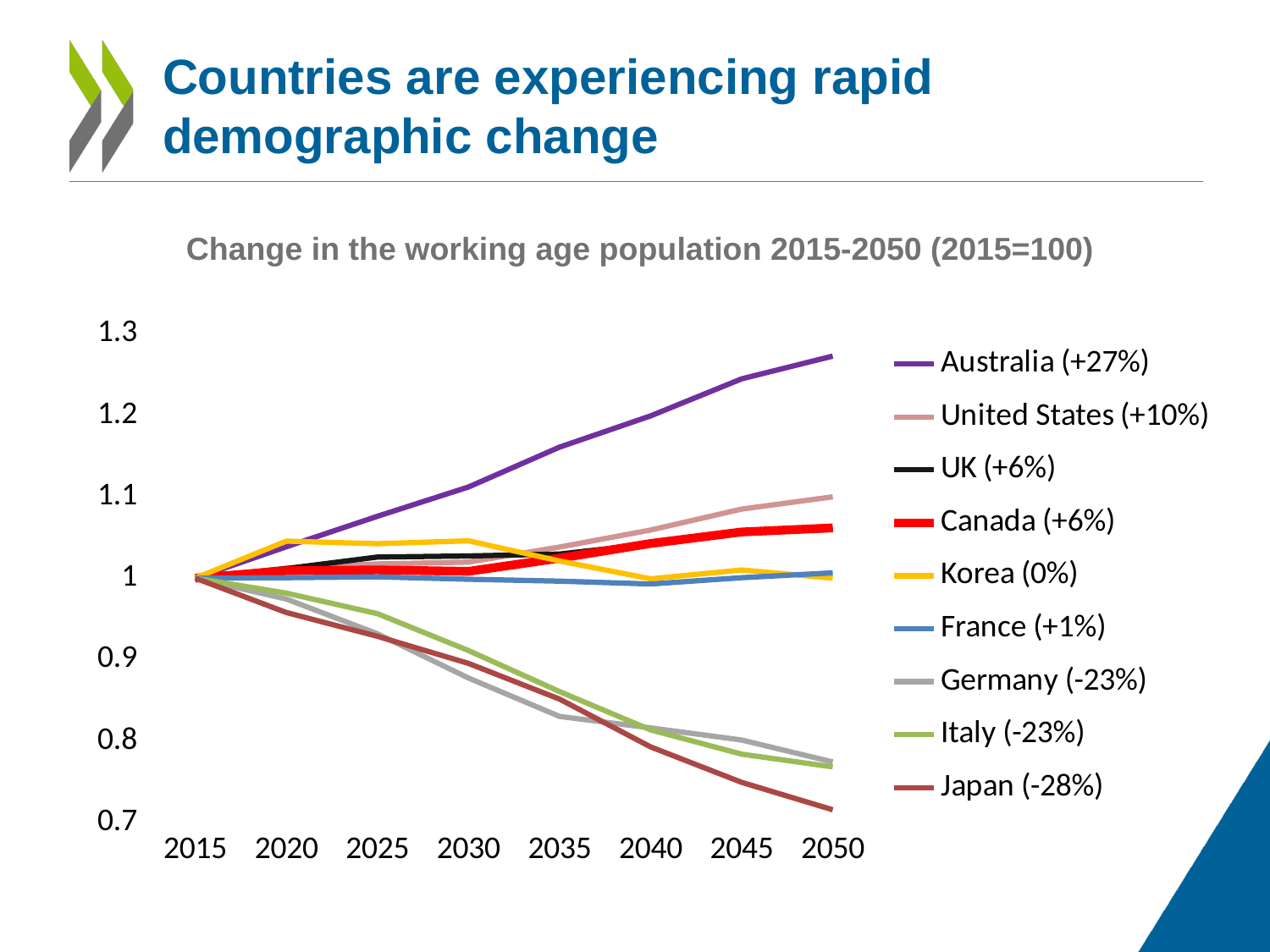
Which country has the lowest value in 2050? Japan What type of chart is shown on the slide? line chart What percentage change does the legend show for Japan? -28% Is the value for Japan in 2050 greater or less than 0.8? less What percentage change does the legend show for Australia? +27% What is the value for Australia in 2015? 1 How many series does the legend list? 9 How many years are marked along the x axis? 8 Which country has the highest value in 2050? Australia What is the chart's title? Change in the working age population 2015-2050 (2015=100) Is the value for Australia in 2050 greater or less than 1.2? greater Does the line for Japan rise or fall from 2015 to 2050? fall